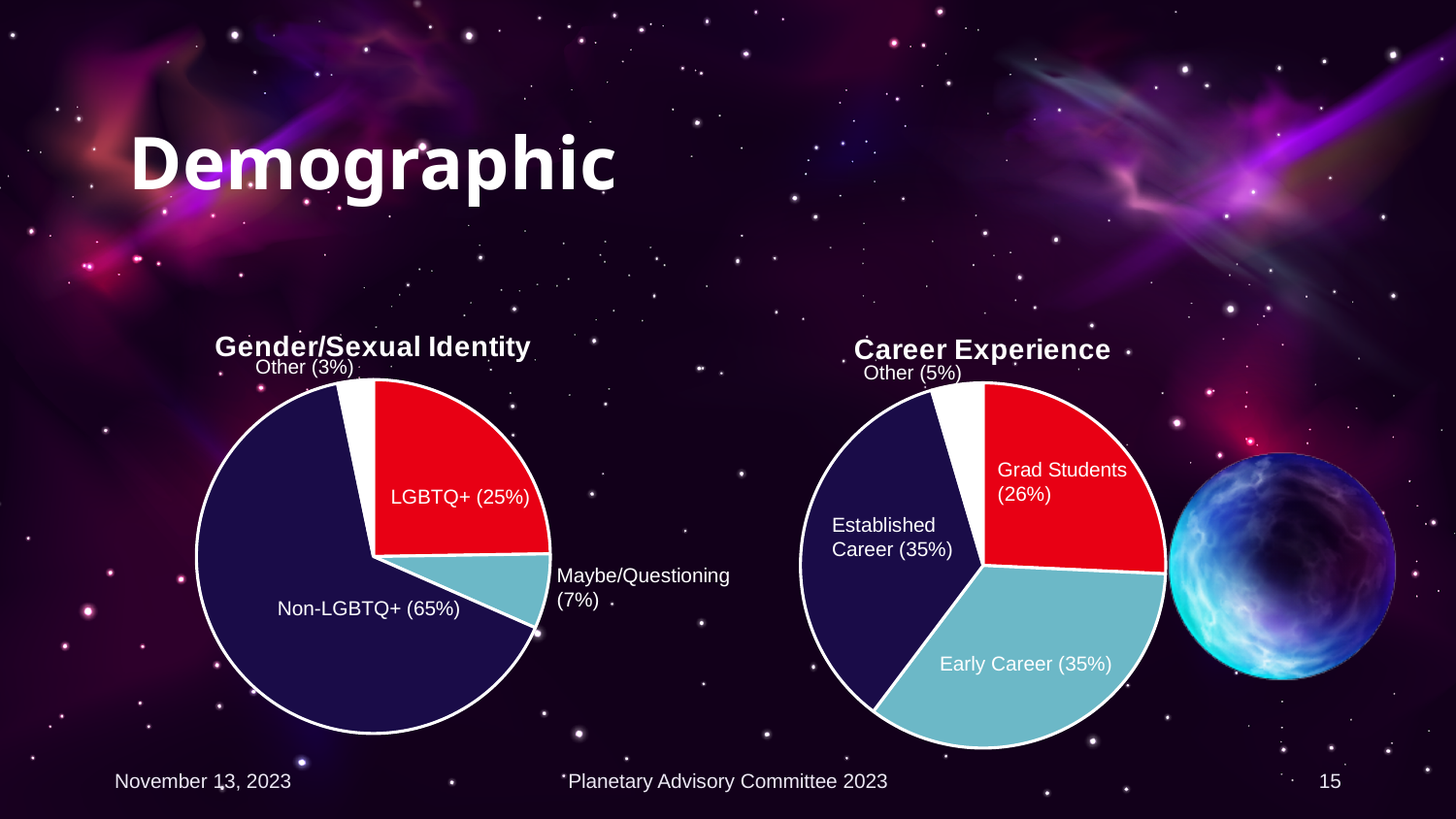
In the Gender/Sexual Identity chart, what is the difference between the LGBTQ+ share and the Maybe/Questioning share? 18% What type of chart is the Career Experience chart? Pie chart In the Gender/Sexual Identity chart, which category has the largest slice? Non-LGBTQ+ In the Gender/Sexual Identity chart, which category has the smallest slice? Other In the Career Experience chart, what share is labelled for Grad Students? 26% In the Career Experience chart, which is larger: Grad Students or Other? Grad Students In the Gender/Sexual Identity chart, what share is labelled for Maybe/Questioning? 7% How many slices does the Gender/Sexual Identity pie chart have? 4 In the Gender/Sexual Identity chart, what share is labelled for Non-LGBTQ+? 65% In the Career Experience chart, which category has the smallest slice? Other What is the title of the chart on the left side of the slide? Gender/Sexual Identity In the Career Experience chart, what share is labelled for Early Career? 35%